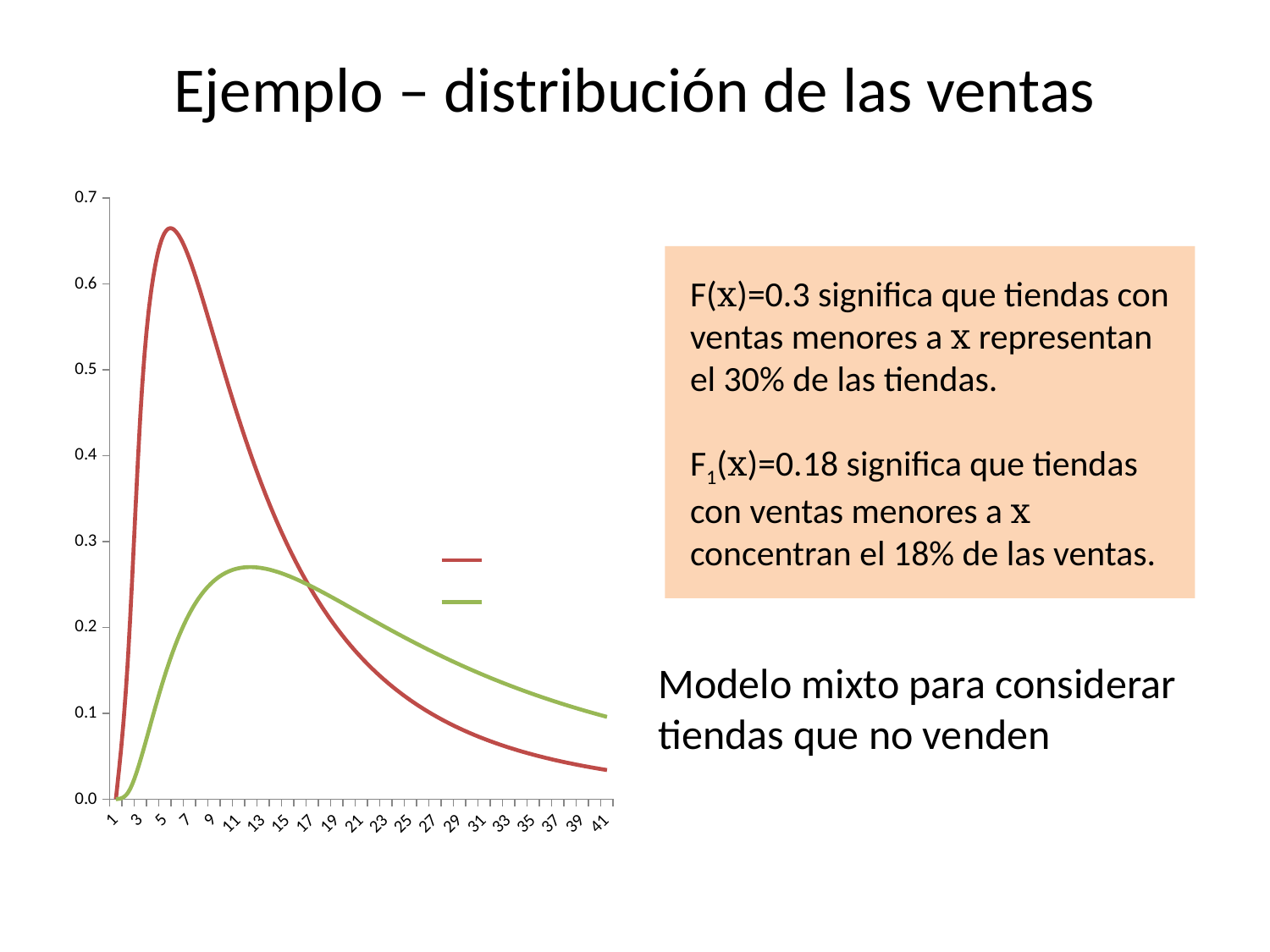
What is the title of the slide containing the chart? Ejemplo – distribución de las ventas Is the peak value of the green line greater or less than 0.3? less What two colours are used for the lines in the chart? red and green What kind of chart is shown on the slide? line chart Is the value of the red line at x = 41 greater or less than 0.1? less After reaching its peak, does the red line rise or fall as x increases? fall Which line reaches the highest value on the chart, the red one or the green one? the red line At x = 5, which line has the higher value, the red one or the green one? the red line At x = 41, which line has the higher value, the red one or the green one? the green line Is the peak value of the red line greater or less than 0.6? greater How many series does the chart's legend list? 2